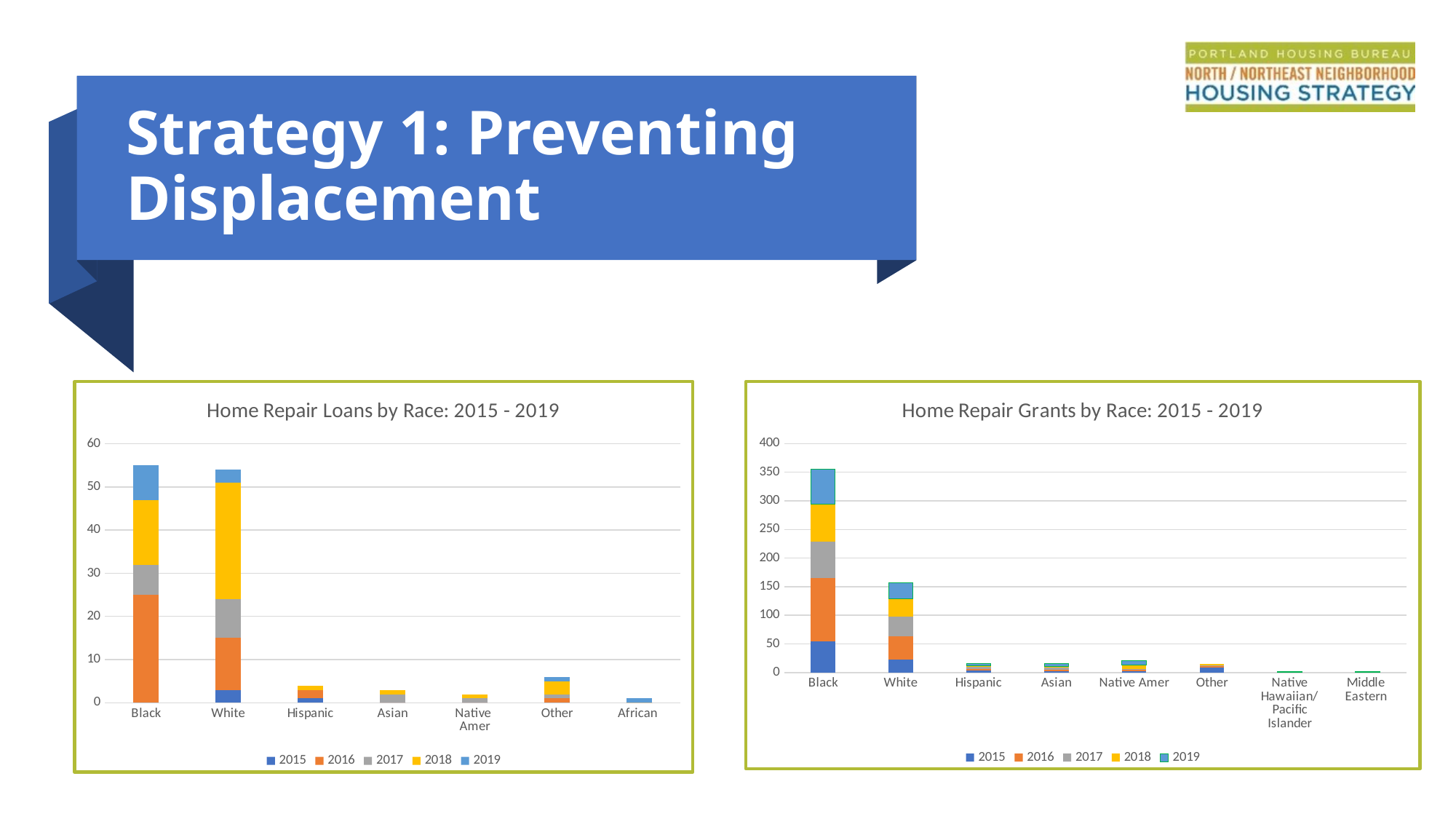
In the 'Home Repair Grants by Race: 2015 - 2019' chart, is the total for Black greater or less than 300? greater In the 'Home Repair Loans by Race: 2015 - 2019' chart, is the total for Other greater or less than 10? less In the 'Home Repair Loans by Race: 2015 - 2019' chart, is the total for Black greater or less than 50? greater In the 'Home Repair Loans by Race: 2015 - 2019' chart, which has the larger total, Other or Asian? Other How many race categories are shown on the x axis of the 'Home Repair Grants by Race: 2015 - 2019' chart? 8 Which years are listed in the legend of the 'Home Repair Grants by Race: 2015 - 2019' chart? 2015, 2016, 2017, 2018, 2019 In the 'Home Repair Grants by Race: 2015 - 2019' chart, which race has the highest total? Black In the 'Home Repair Grants by Race: 2015 - 2019' chart, which has the larger total, Black or White? Black What type of chart is the 'Home Repair Loans by Race: 2015 - 2019' chart? stacked bar chart How many series does the legend of the 'Home Repair Loans by Race: 2015 - 2019' chart list? 5 How many race categories are shown on the x axis of the 'Home Repair Loans by Race: 2015 - 2019' chart? 7